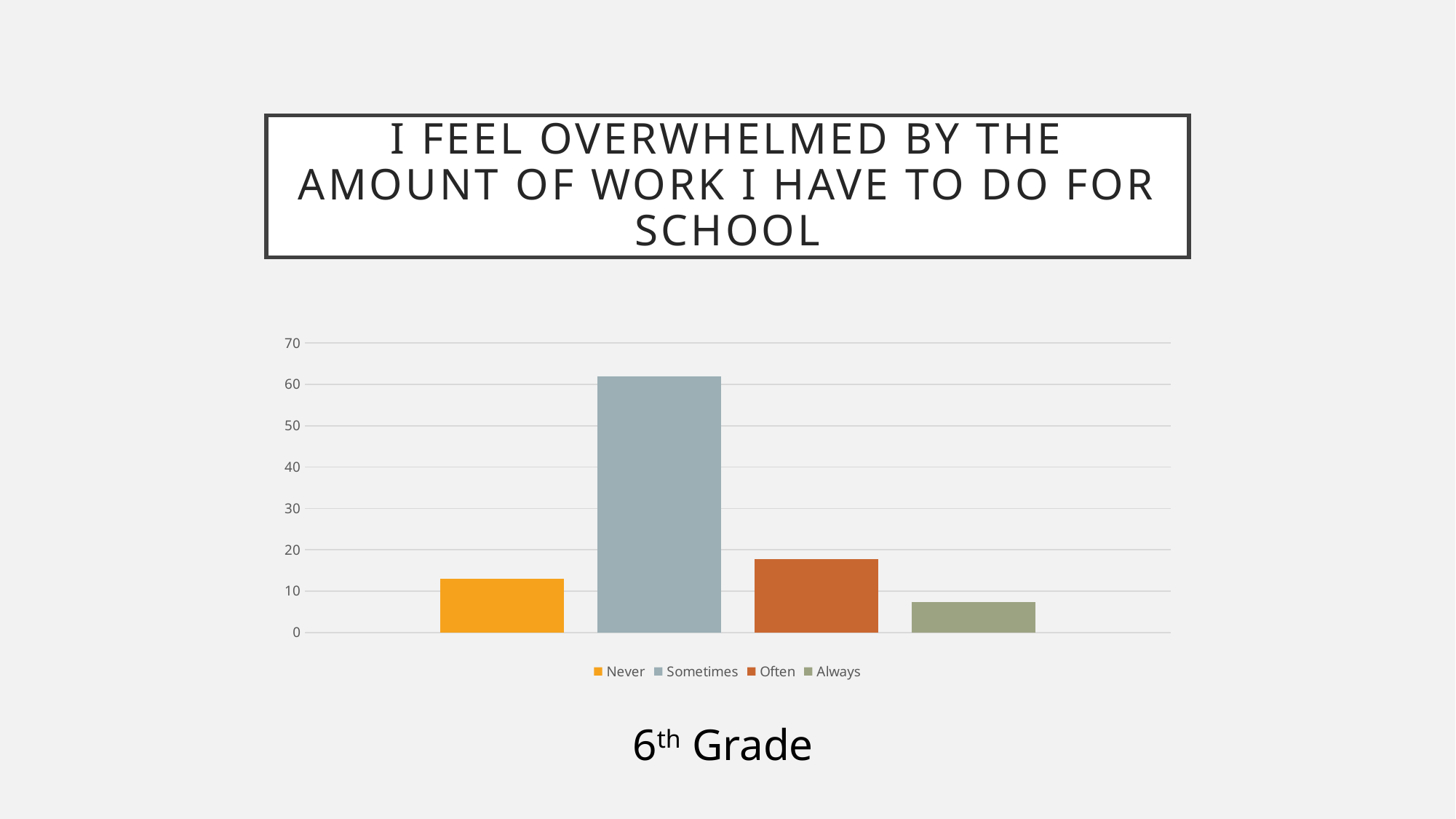
Which is larger, the value for Often or the value for Never? Often Is the value for Always greater or less than 10? less Which response category has the lowest bar? Always Is the value for Sometimes greater or less than 50? greater Which grade does the chart on the slide refer to? 6th Grade What kind of chart is shown on the slide? bar chart How many entries does the chart's legend list? 4 How many bars are plotted in the chart? 4 Is the value for Often greater or less than 20? less Which response category has the highest bar? Sometimes